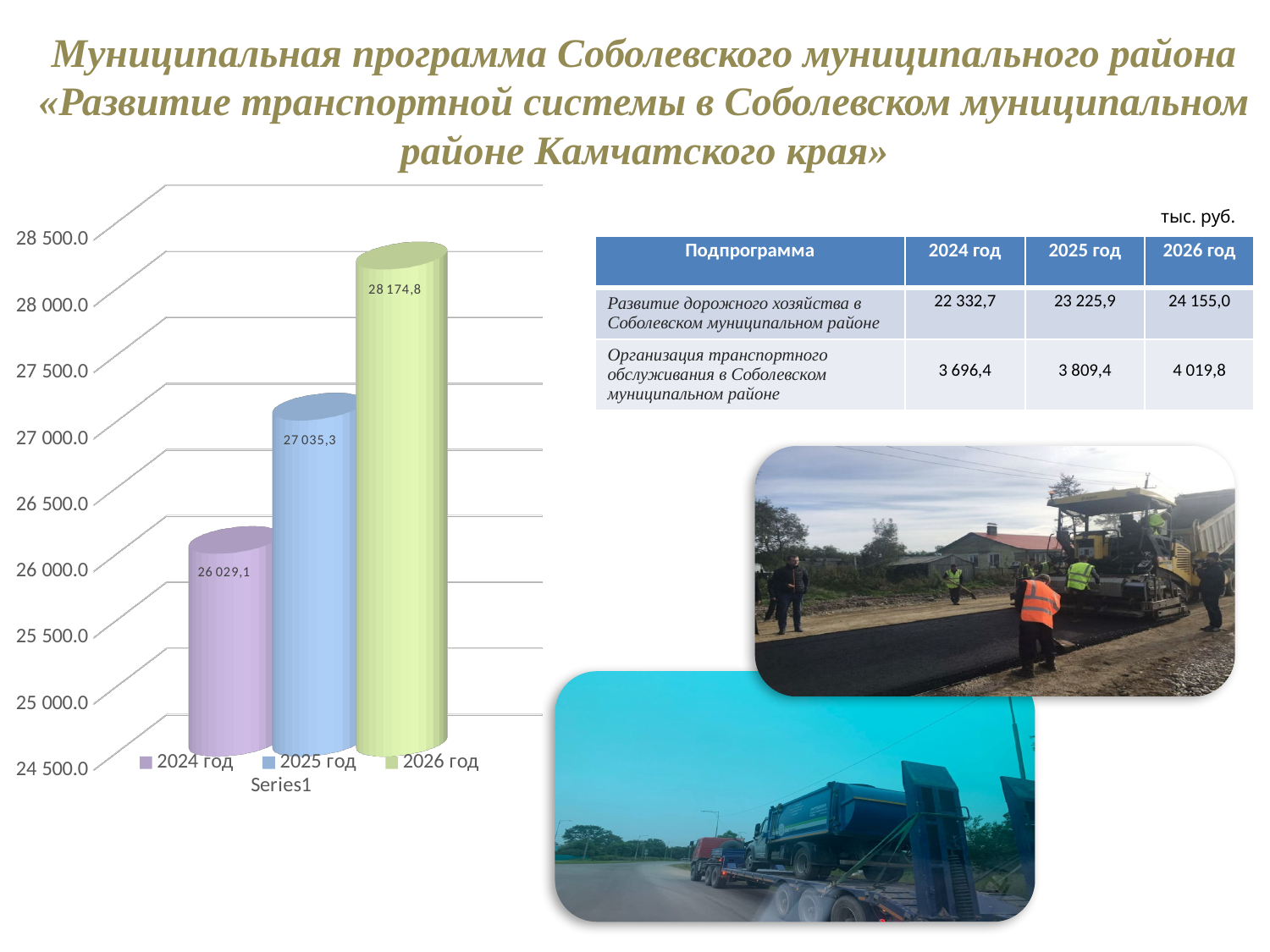
Do the values in the bar chart rise or fall from 2024 год to 2026 год? rise What type of chart is shown on the left of the slide? bar chart What is the value shown for 2026 год in the bar chart? 28 174,8 How many bars are plotted in the bar chart? 3 Which year has the lowest value in the bar chart? 2024 год What is the difference between the values for 2026 год and 2025 год in the bar chart? 1 139,5 What is the difference between the values for 2025 год and 2024 год in the bar chart? 1 006,2 What is the value shown for 2025 год in the bar chart? 27 035,3 Which is larger in the bar chart, the value for 2025 год or the value for 2026 год? 2026 год Which year has the highest value in the bar chart? 2026 год Is the value for 2024 год in the bar chart greater or less than 26 500.0? less What is the value shown for 2024 год in the bar chart? 26 029,1